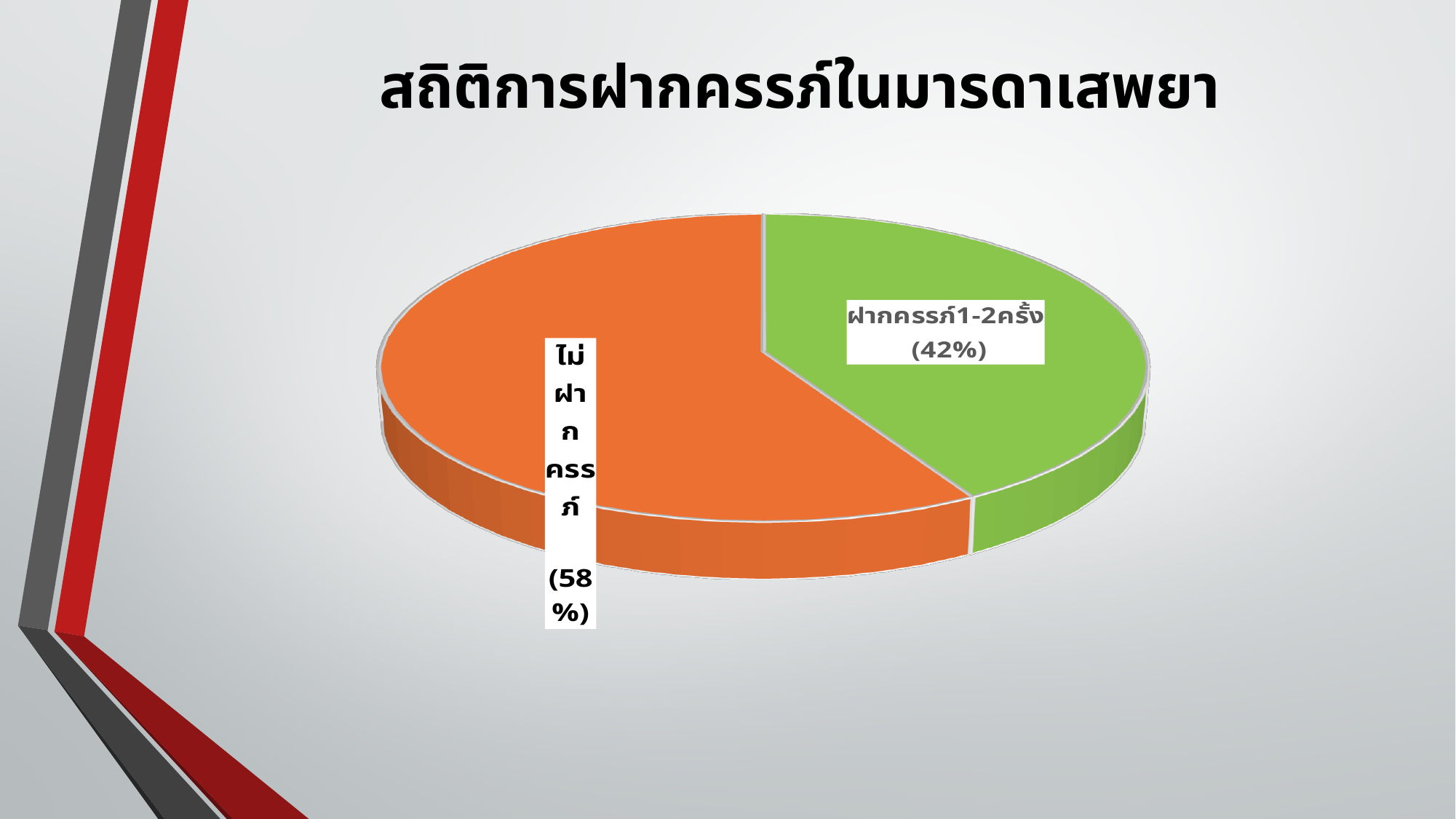
What percentage is shown for ไม่ฝากครรภ์? 58% What is the difference in percentage points between ไม่ฝากครรภ์ and ฝากครรภ์1-2ครั้ง? 16 Which slice of the pie chart is the largest? ไม่ฝากครรภ์ How many slices does the pie chart have? 2 Which slice of the pie chart is the smallest? ฝากครรภ์1-2ครั้ง Which is larger, the share for ไม่ฝากครรภ์ or the share for ฝากครรภ์1-2ครั้ง? ไม่ฝากครรภ์ Is the share for ไม่ฝากครรภ์ greater or less than 50%? greater What percentage is shown for ฝากครรภ์1-2ครั้ง? 42% What share of the pie does the ฝากครรภ์1-2ครั้ง slice represent? 42% What kind of chart is shown on the slide? Pie chart What is the title of the chart on the slide? สถิติการฝากครรภ์ในมารดาเสพยา What colour is the ไม่ฝากครรภ์ slice? Orange